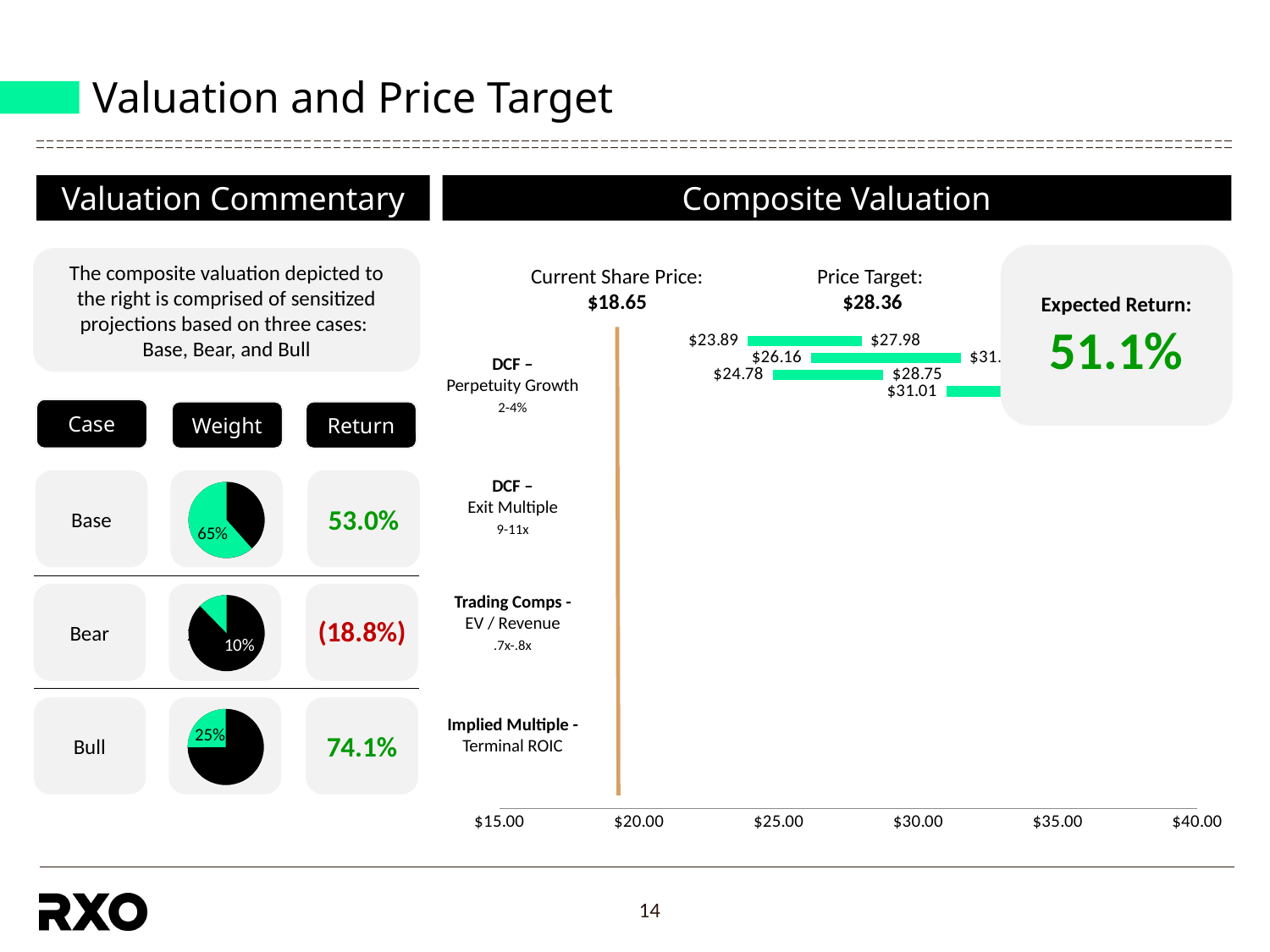
On the Composite Valuation chart, what is the Price Target shown? $28.36 What are the minimum and maximum values shown on the x axis of the Composite Valuation chart? $15.00 and $40.00 Which case has the largest weight according to the Weight pie charts? Base On the Composite Valuation chart, what is the Current Share Price shown? $18.65 How many valuation methods are listed as categories on the Composite Valuation chart? 4 What kind of chart is the Composite Valuation chart? bar chart Which case has the smallest weight according to the Weight pie charts? Bear In the Weight pie chart for the Base case, what share is highlighted in green? 65% In the Weight pie chart for the Bull case, what share is highlighted in green? 25% In the Weight pie chart for the Bear case, what share is highlighted in green? 10% On the Composite Valuation chart, what is the difference between the $27.98 and $23.89 labels on the first bar? $4.09 On the Composite Valuation chart, what is the high end of the range that starts at $23.89? $27.98